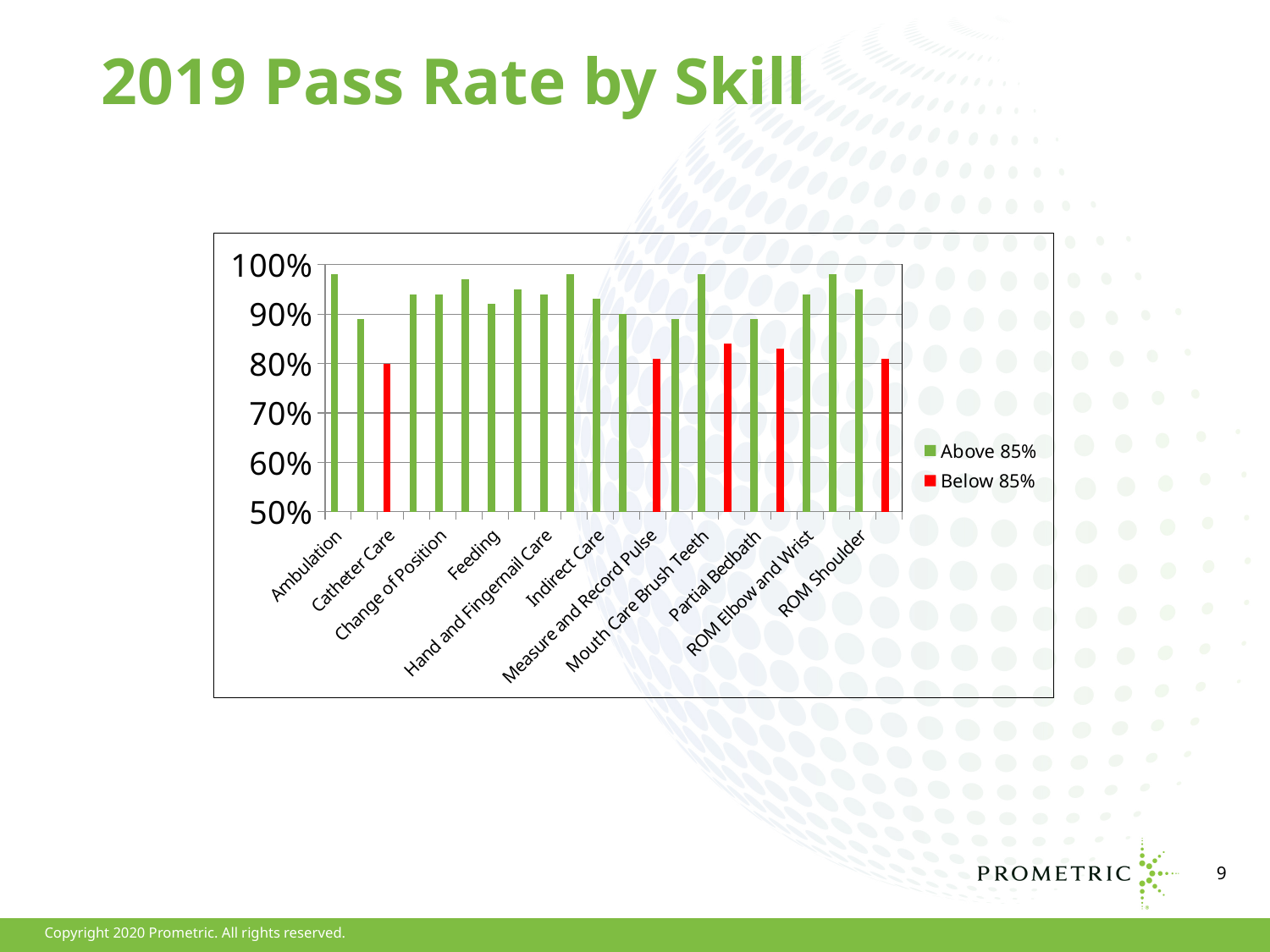
What is the title of the slide's chart? 2019 Pass Rate by Skill Is the pass rate for Measure and Record Pulse greater or less than 85%? less Which has the higher pass rate, Ambulation or Catheter Care? Ambulation Is the pass rate for Feeding greater or less than 85%? greater What type of chart is shown on the slide? Bar chart Which has the higher pass rate, ROM Elbow and Wrist or Measure and Record Pulse? ROM Elbow and Wrist Is the pass rate for Ambulation greater or less than 90%? greater What are the two legend entries in the chart? Above 85% and Below 85% How many series does the legend list? 2 How many red (Below 85%) bars are in the chart? 5